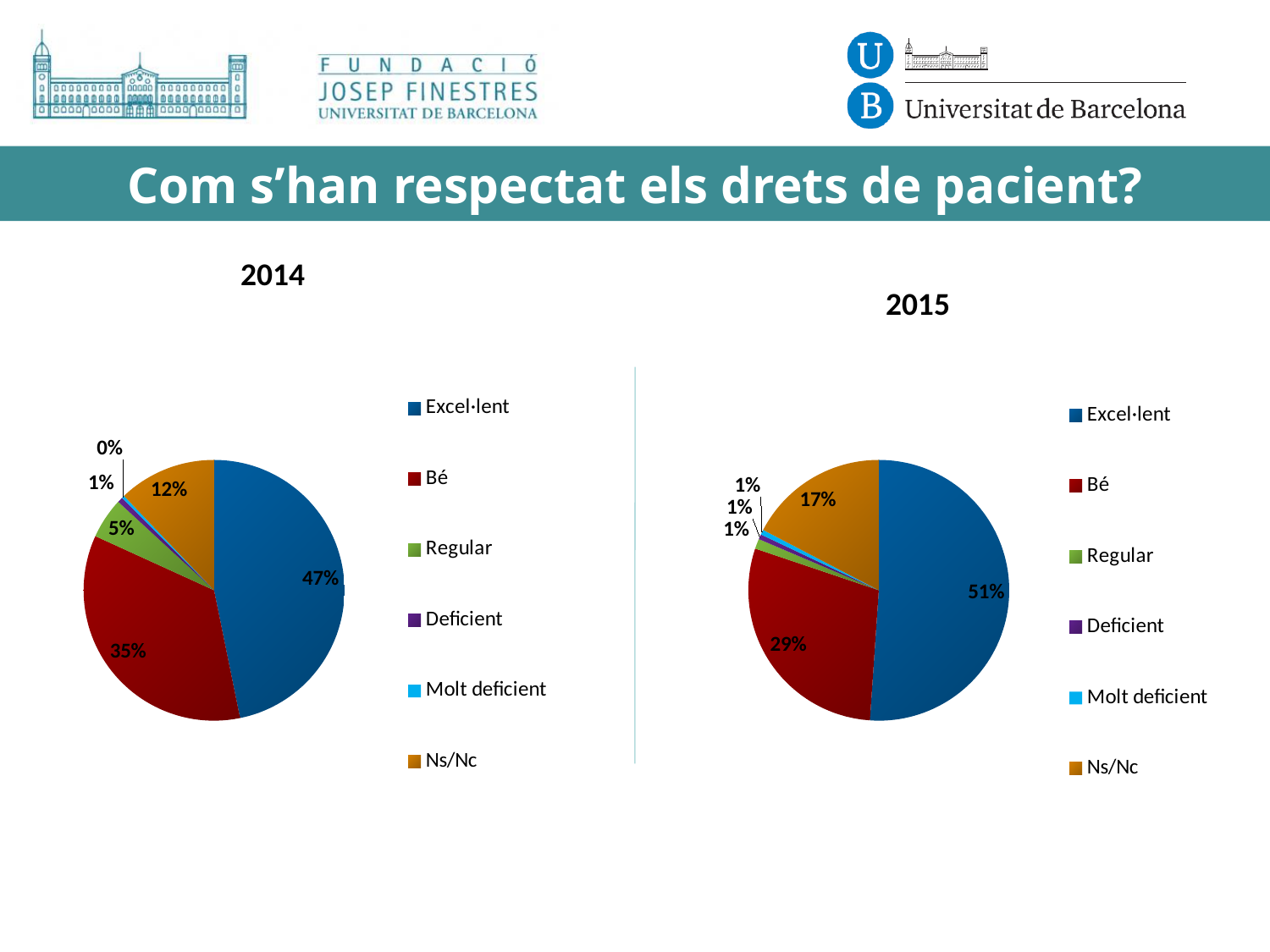
In the 2014 chart, which category has the smallest share? Molt deficient In the 2014 chart, what percentage is shown for Regular? 5% In the 2015 chart, what percentage is shown for Bé? 29% In the 2015 chart, what percentage is shown for Ns/Nc? 17% How many entries does the legend of the 2015 chart list? 6 In the 2015 chart, which category has the largest share? Excel·lent In the 2014 chart, what percentage is shown for Excel·lent? 47% What type of chart is used for the 2014 data? Pie chart In the 2014 chart, what is the difference between the Excel·lent and Bé shares? 12% Which is larger in the 2015 chart, the share for Bé or the share for Ns/Nc? Bé In the 2015 chart, what percentage is shown for Regular? 1% In the 2014 chart, what percentage is shown for Ns/Nc? 12%